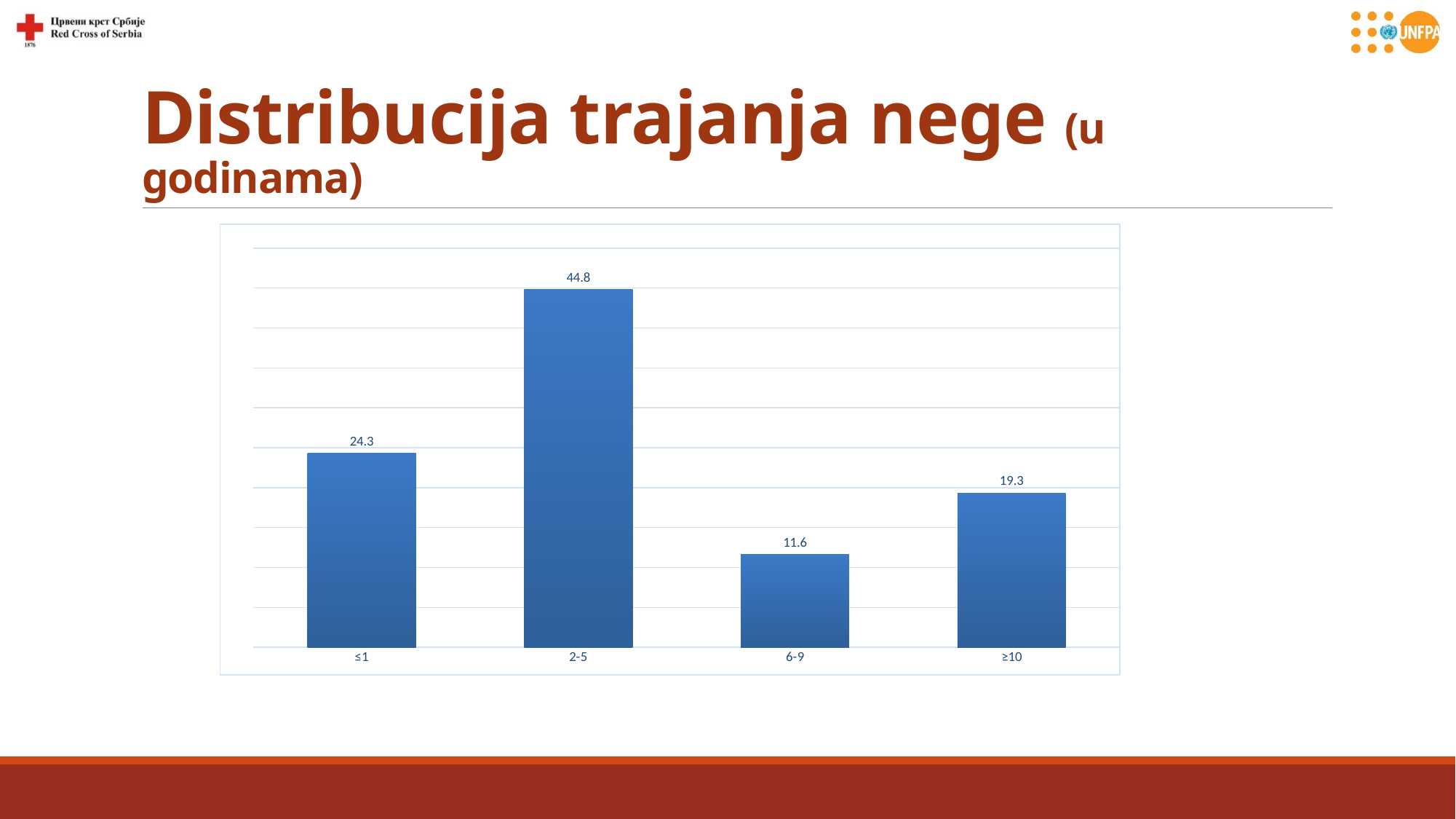
What is the value for the ≥10 category? 19.3 How many categories are shown on the x axis? 4 Which is larger, the value for ≤1 or the value for ≥10? ≤1 What is the title of the slide? Distribucija trajanja nege (u godinama) What is the difference between the values for ≥10 and 6-9? 7.7 What kind of chart is shown on the slide? bar chart Which category has the lowest value? 6-9 What is the value for the 2-5 category? 44.8 What is the value for the ≤1 category? 24.3 What is the value for the 6-9 category? 11.6 Which category has the highest value? 2-5 What is the difference between the values for 2-5 and ≤1? 20.5